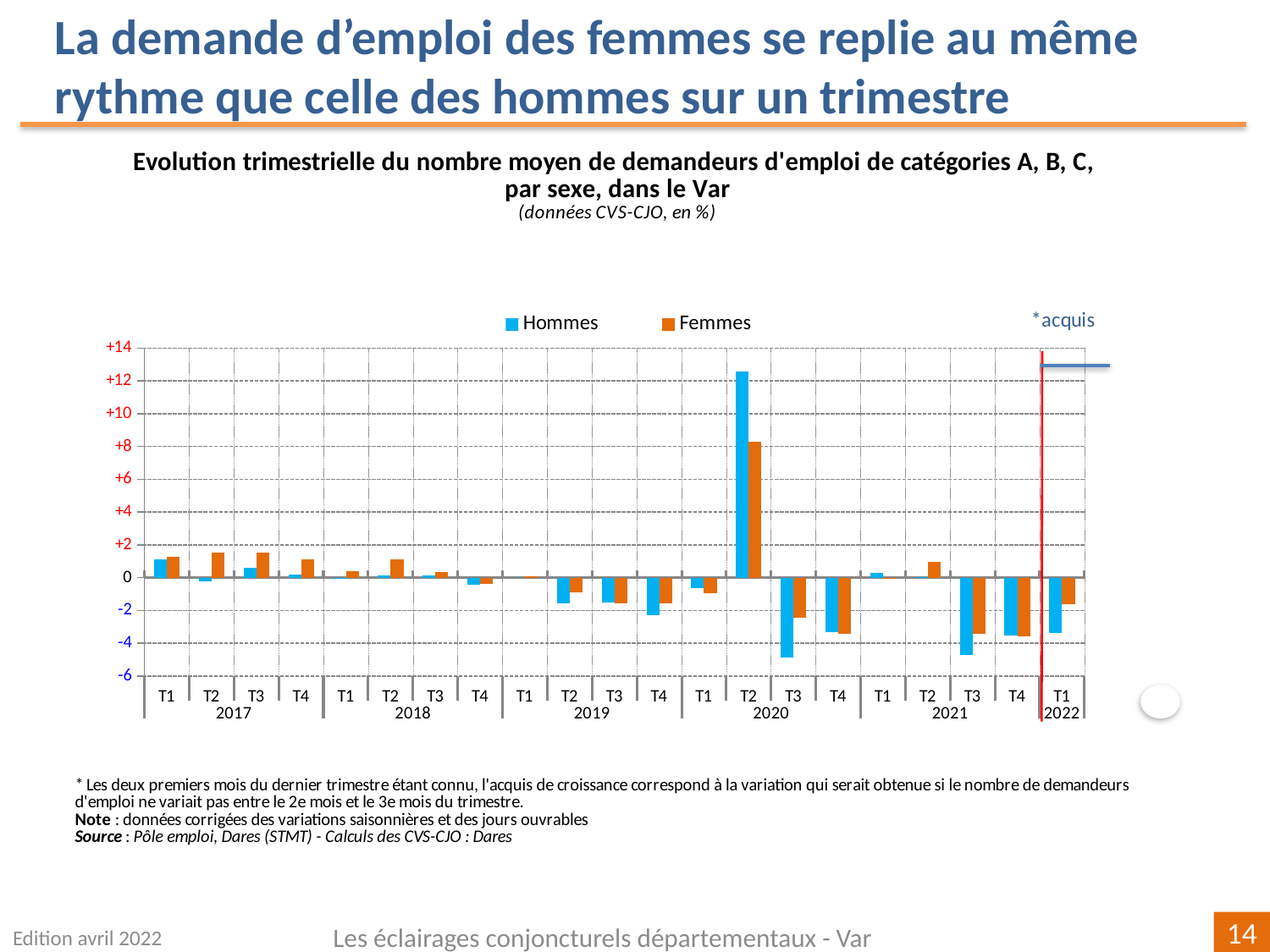
In T2 2020, which series has the larger value, Hommes or Femmes? Hommes What label is attached to the asterisk marking the last quarter (T1 2022)? acquis In which quarter is the value for Hommes the highest? T2 2020 In which quarter is the value for Femmes the highest? T2 2020 In T1 2022, which series shows the larger decline, Hommes or Femmes? Hommes How many series does the legend list? 2 How many quarters are plotted on the x axis? 21 What kind of chart is shown on the slide? bar chart Is the value for Hommes in T2 2020 greater or less than +12? greater Is the value for Femmes in T2 2020 greater or less than +6? greater What are the two series named in the legend? Hommes and Femmes Is the value for Hommes in T3 2020 greater or less than -4? less